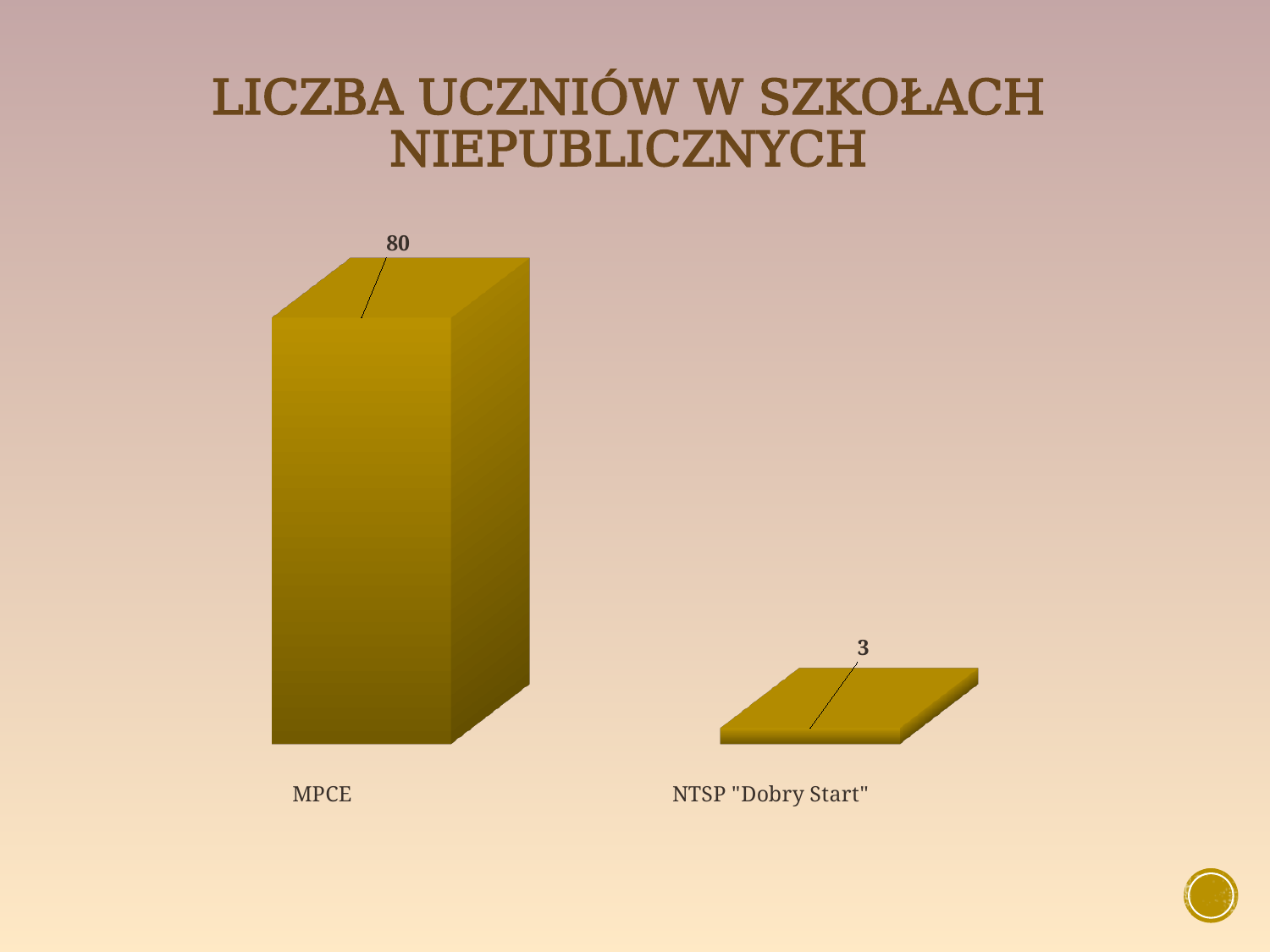
What is the value for NTSP "Dobry Start"? 3 What is the total of the two values shown in the chart? 83 What kind of chart is shown on the slide? Bar chart Which category has the highest value? MPCE Which category has the lowest value? NTSP "Dobry Start" What is the value for MPCE? 80 What is the difference between the values for MPCE and NTSP "Dobry Start"? 77 Do the values rise or fall from left to right across the categories? Fall Which is larger, the value for MPCE or the value for NTSP "Dobry Start"? MPCE What is the title of the slide? LICZBA UCZNIÓW W SZKOŁACH NIEPUBLICZNYCH How many categories are shown in the chart? 2